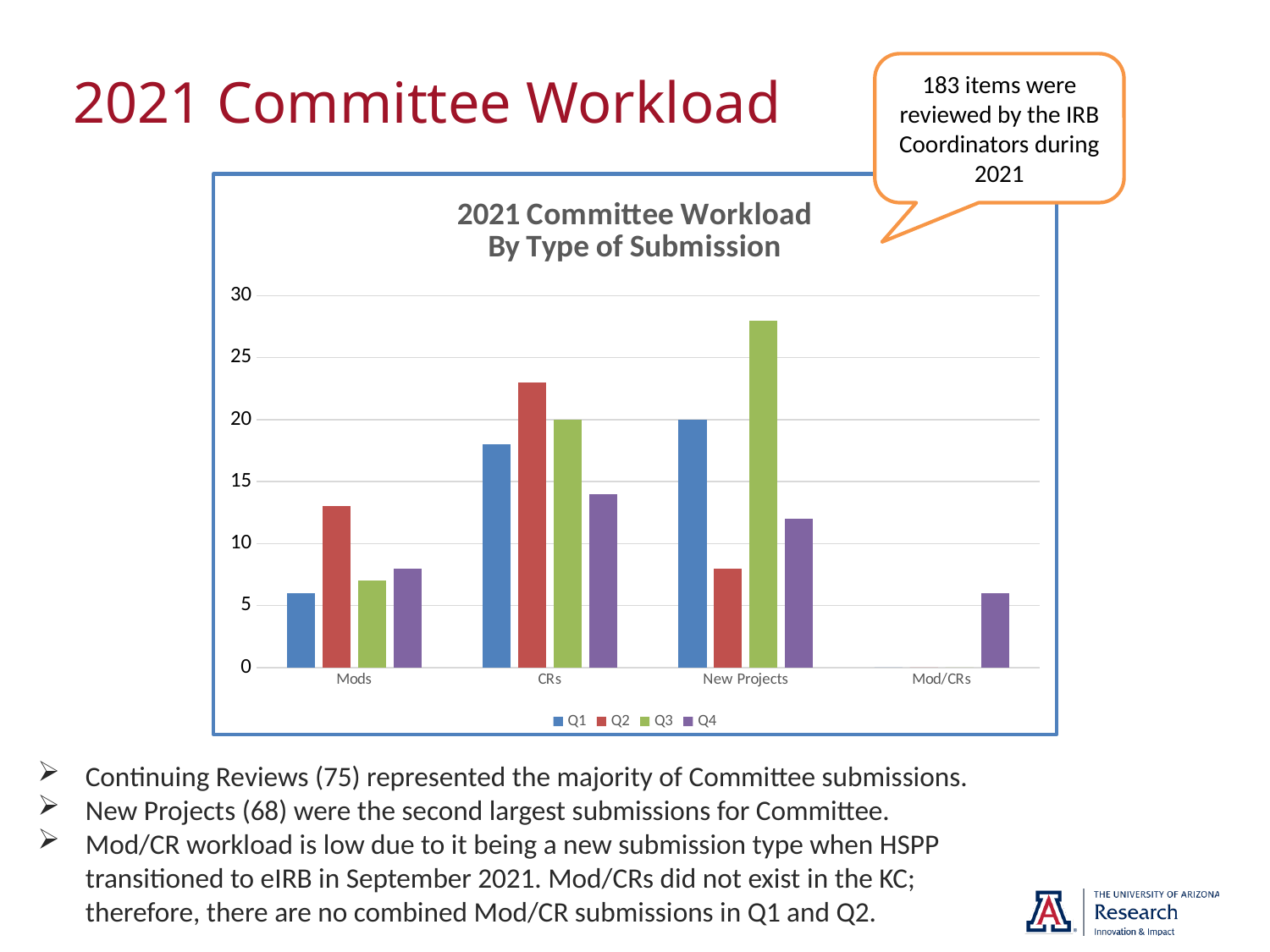
Is the Q3 value for New Projects greater or less than 25? greater What is the Q1 value for New Projects? 20 Is the Q2 value for Mods greater or less than 10? greater For New Projects, which quarter has the highest value? Q3 How many submission type categories are shown on the x axis? 4 Is the Q2 value for CRs greater or less than 20? greater For CRs, which is larger: the Q2 value or the Q4 value? Q2 How many series does the legend list? 4 For Mods, which quarter has the lowest value? Q1 What is the title of the chart? 2021 Committee Workload By Type of Submission What kind of chart is shown on the slide? bar chart